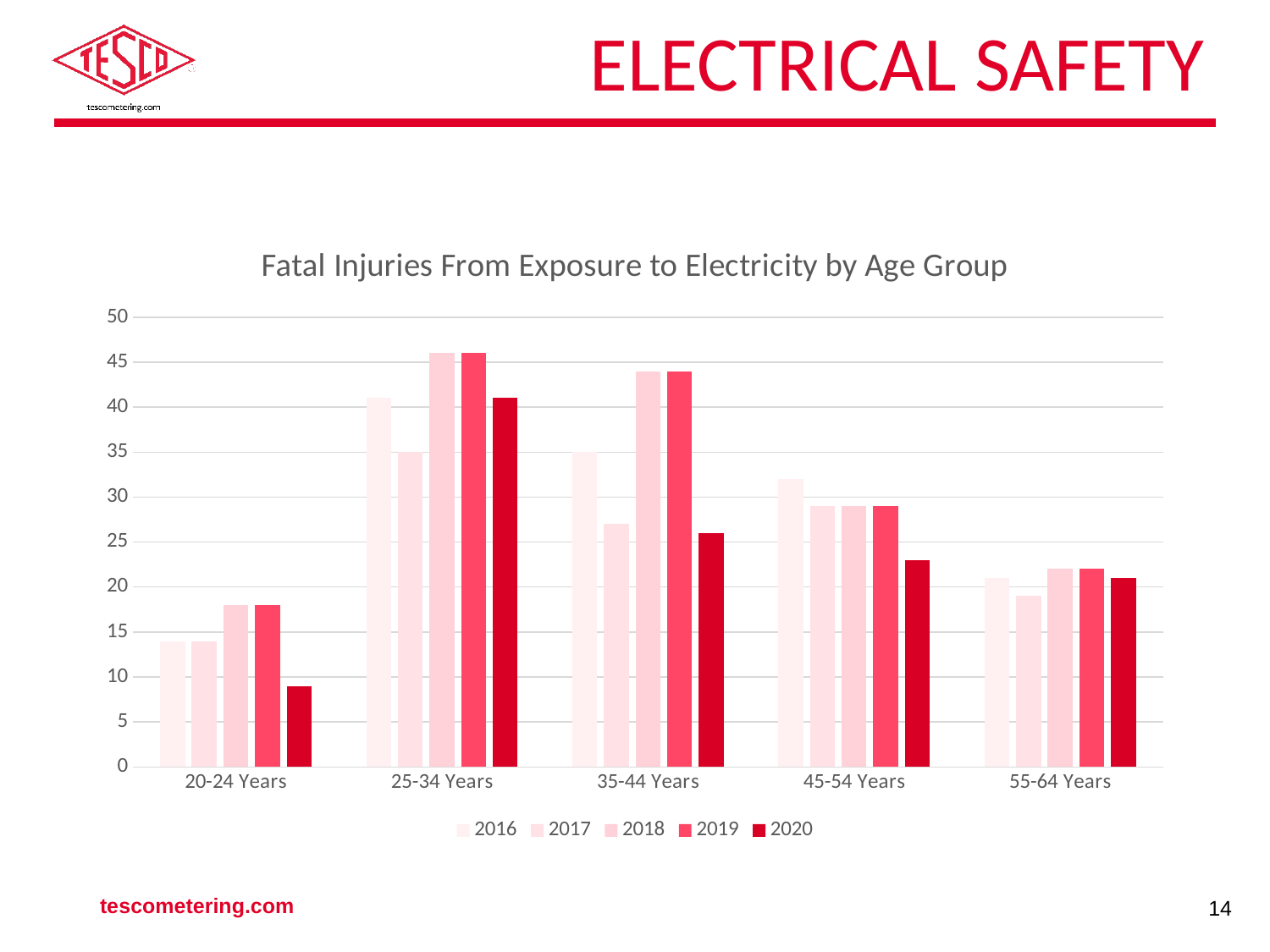
What kind of chart is shown on the slide? bar chart Which age group has the lowest value for 2020? 20-24 Years Which age group has the highest value for 2020? 25-34 Years Is the 2020 value for 20-24 Years greater or less than 10? less Is the 2018 value for 25-34 Years greater or less than 45? greater Is the 2020 value for 35-44 Years greater or less than 30? less How many age groups are shown on the x axis? 5 For 45-54 Years, which is larger: the 2016 value or the 2020 value? 2016 How many series does the legend list? 5 What is the title of the chart? Fatal Injuries From Exposure to Electricity by Age Group Which age group has the highest value for 2016? 25-34 Years For 55-64 Years, which is larger: the 2017 value or the 2018 value? 2018